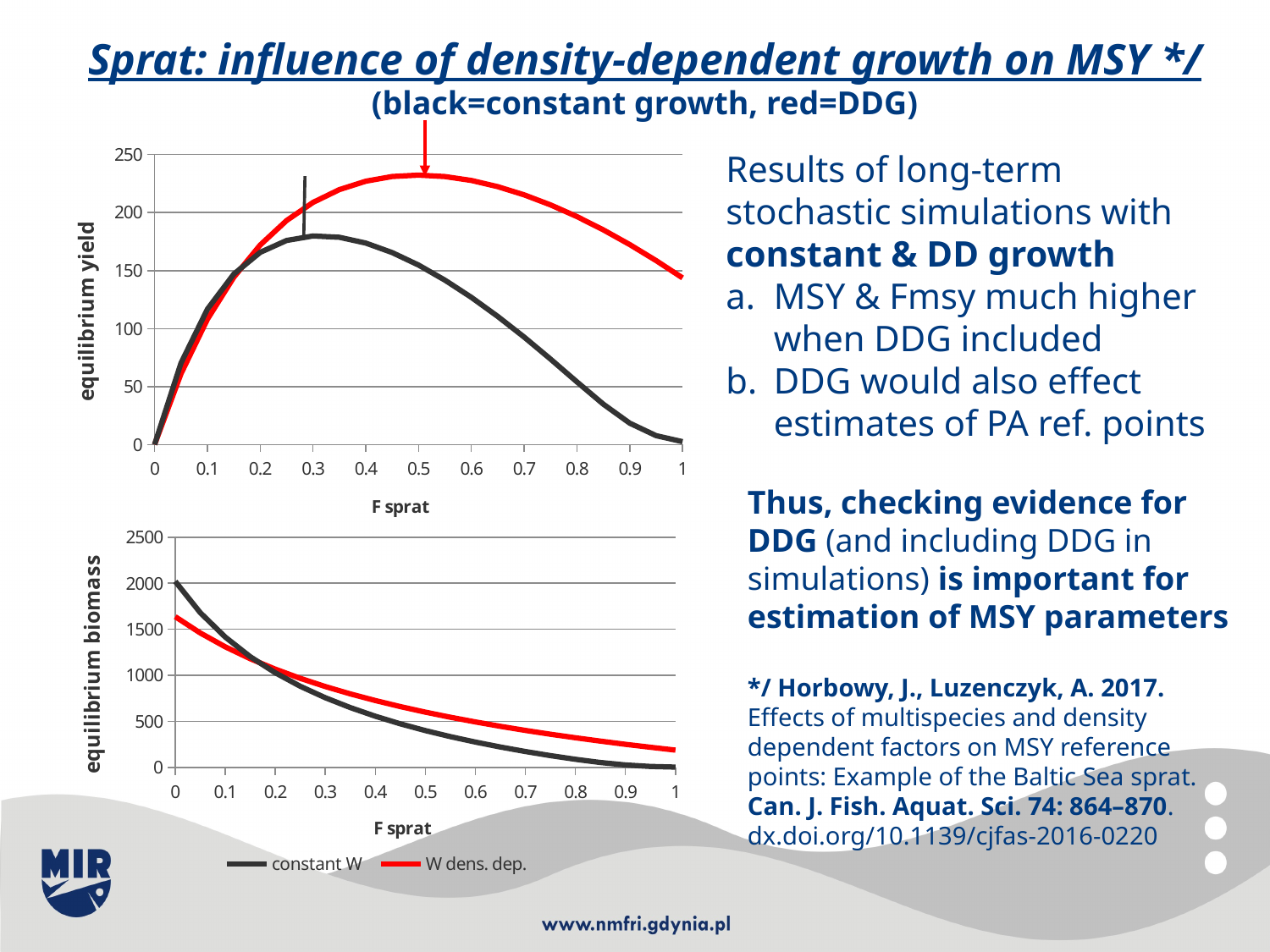
In the bottom chart (equilibrium biomass), do the values rise or fall as F sprat increases? fall In the bottom chart (equilibrium biomass), is the value of the red 'W dens. dep.' line at F sprat = 0 greater or less than 1500? greater In the top chart (equilibrium yield), is the value of the black 'constant W' line at F sprat = 0.9 greater or less than 50? less How many series does the legend at the bottom of the slide list? 2 What is the label of the y axis of the top chart? equilibrium yield In the top chart (equilibrium yield), at F sprat = 0.7, which line is higher, the black 'constant W' or the red 'W dens. dep.'? W dens. dep. In the top chart (equilibrium yield), which series reaches the higher peak, 'constant W' or 'W dens. dep.'? W dens. dep. In the bottom chart (equilibrium biomass), is the value of the black 'constant W' line at F sprat = 0.5 greater or less than 500? less What colour is the 'W dens. dep.' series in the charts? red What kind of chart is the top chart (equilibrium yield vs F sprat)? line chart In the bottom chart (equilibrium biomass), at F sprat = 0, which line is higher, 'constant W' or 'W dens. dep.'? constant W